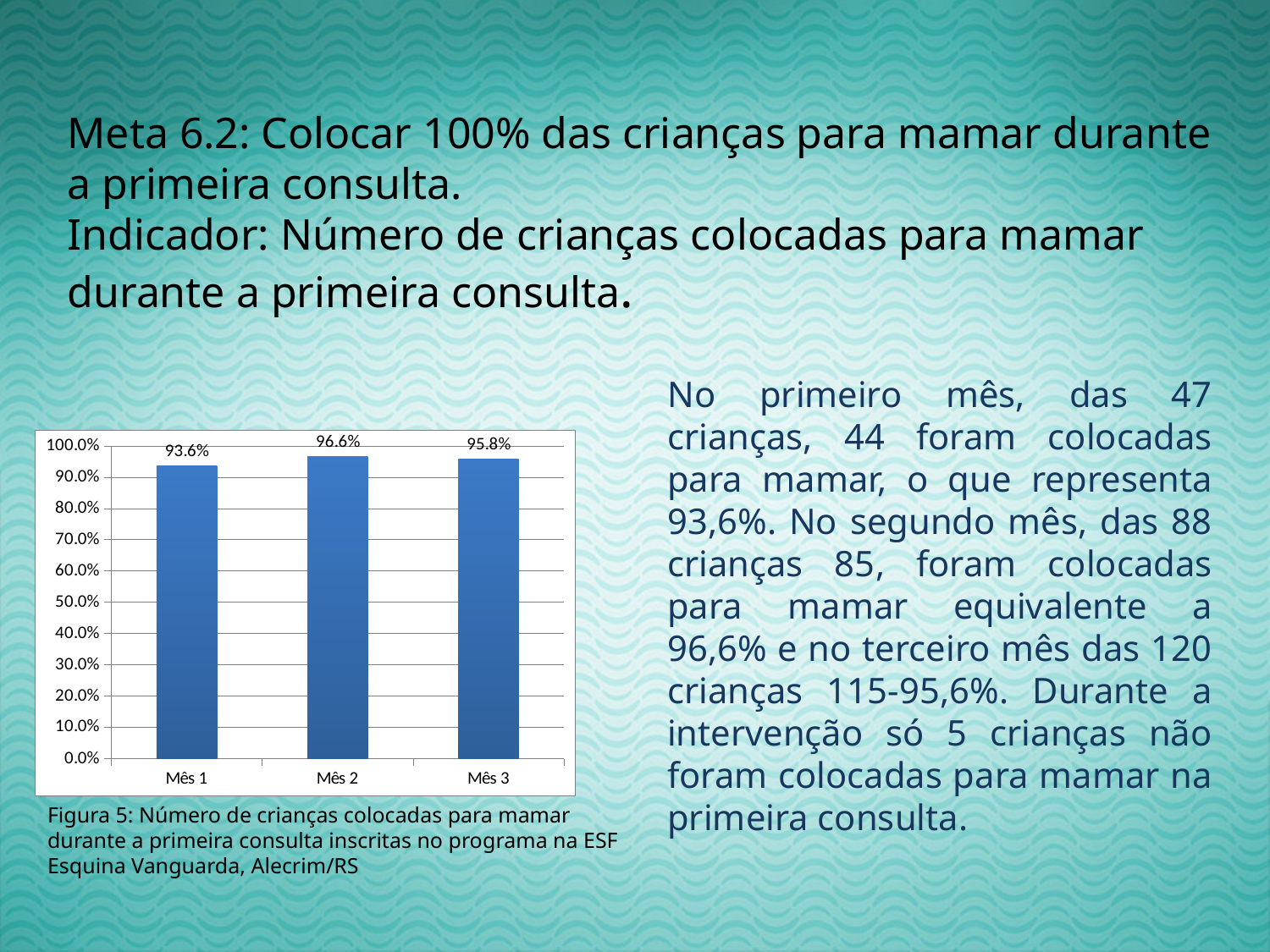
What is the value for Mês 1? 93.6% What is the value for Mês 3? 95.8% Which month has the lowest value? Mês 1 Is the value for Mês 1 greater or less than 90.0%? greater How many categories are shown on the x axis? 3 What is the value for Mês 2? 96.6% What is the difference between the values for Mês 2 and Mês 1? 3.0% What is the figure caption below the chart? Figura 5: Número de crianças colocadas para mamar durante a primeira consulta inscritas no programa na ESF Esquina Vanguarda, Alecrim/RS Which month has the highest value? Mês 2 What kind of chart is shown on the slide? bar chart Which is larger, the value for Mês 1 or the value for Mês 3? Mês 3 What is the difference between the values for Mês 2 and Mês 3? 0.8%